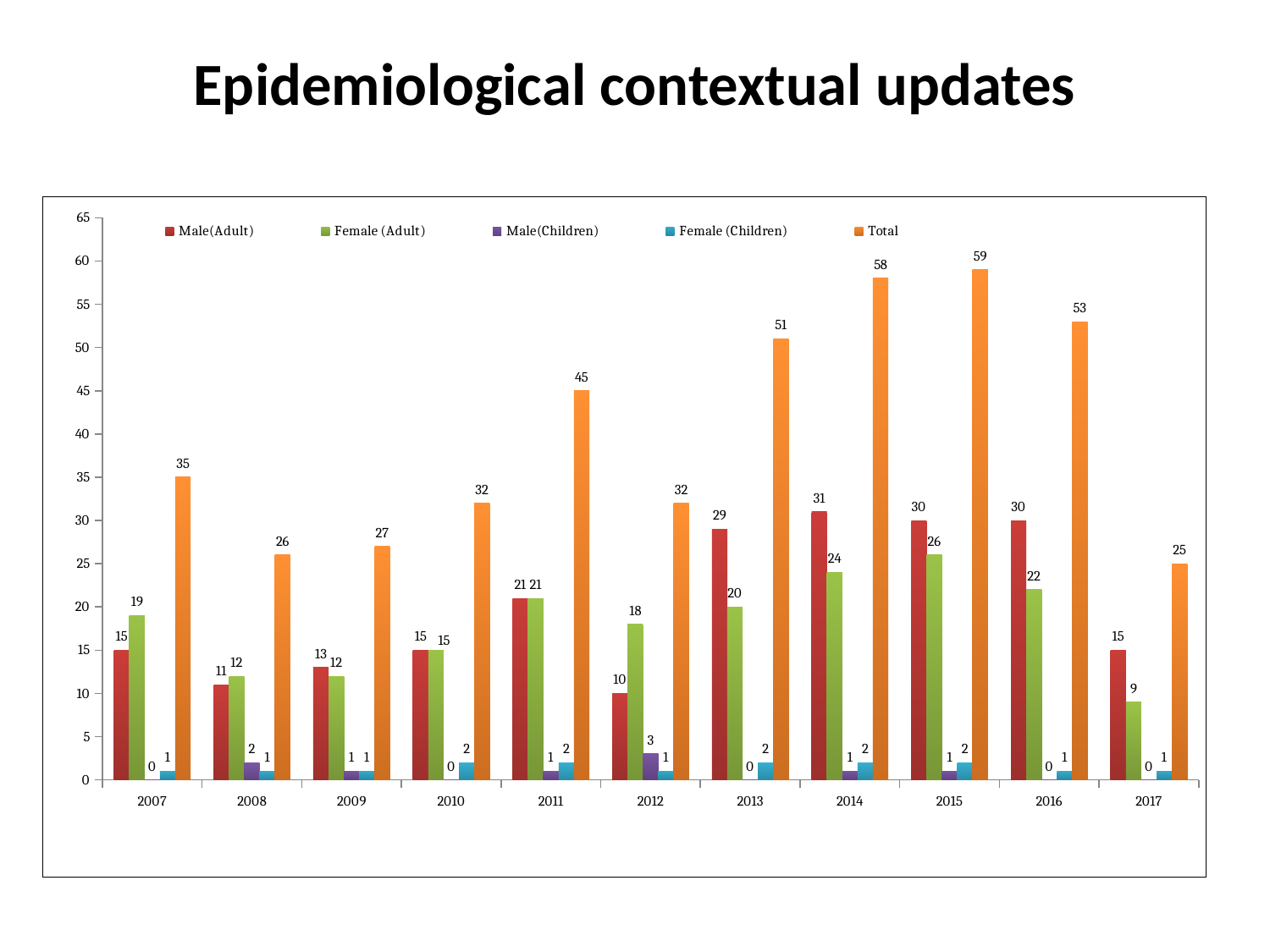
Which is larger in 2012, Male(Adult) or Female (Adult)? Female (Adult) Which year has the highest Total? 2015 What kind of chart is shown on the slide? Bar chart How many series does the legend list? 5 What is the Total value for 2015? 59 What is the Male(Children) value for 2012? 3 Which year has the lowest Total? 2017 What is the Female (Adult) value for 2014? 24 What is the Male(Adult) value for 2013? 29 What is the title of the slide containing the chart? Epidemiological contextual updates How many years are shown on the x axis? 11 What is the difference between the Total for 2014 and the Total for 2007? 23